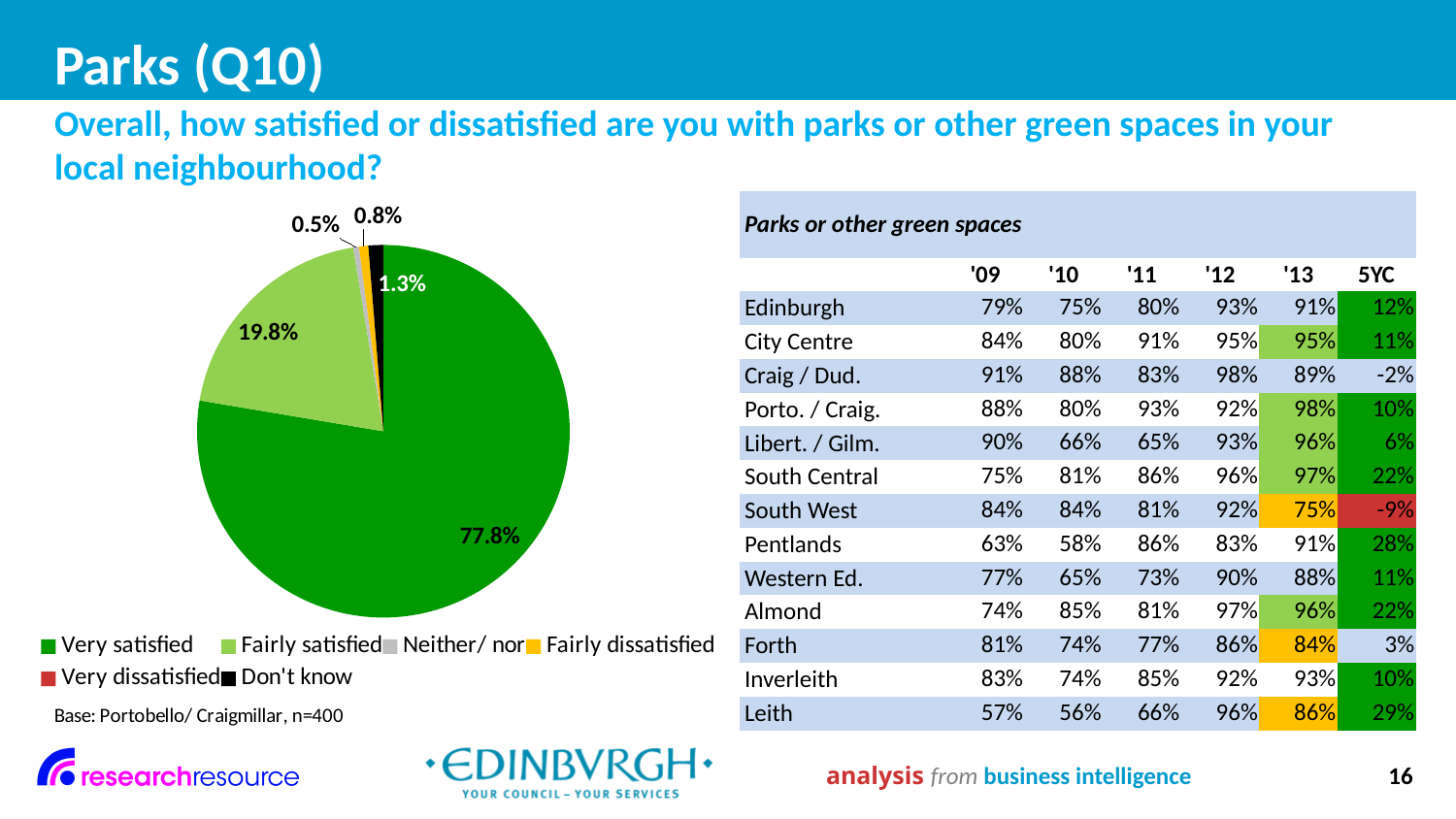
What share of the pie does the 'Very satisfied' slice represent? 77.8% What colour represents 'Very satisfied' in the pie chart? Dark green What type of chart is shown on the slide? Pie chart Which response category has the largest slice of the pie chart? Very satisfied Which slice is larger: 'Fairly satisfied' or 'Don't know'? Fairly satisfied What percentage of respondents answered 'Don't know' in the pie chart? 1.3% What percentage of respondents are fairly satisfied with parks or other green spaces? 19.8% What percentage of respondents are very satisfied with parks or other green spaces? 77.8% What is the base (sample size) stated for the pie chart? Portobello/ Craigmillar, n=400 What is the difference in percentage points between the 'Very satisfied' and 'Fairly satisfied' slices? 58.0 percentage points How many response categories does the pie chart legend list? 6